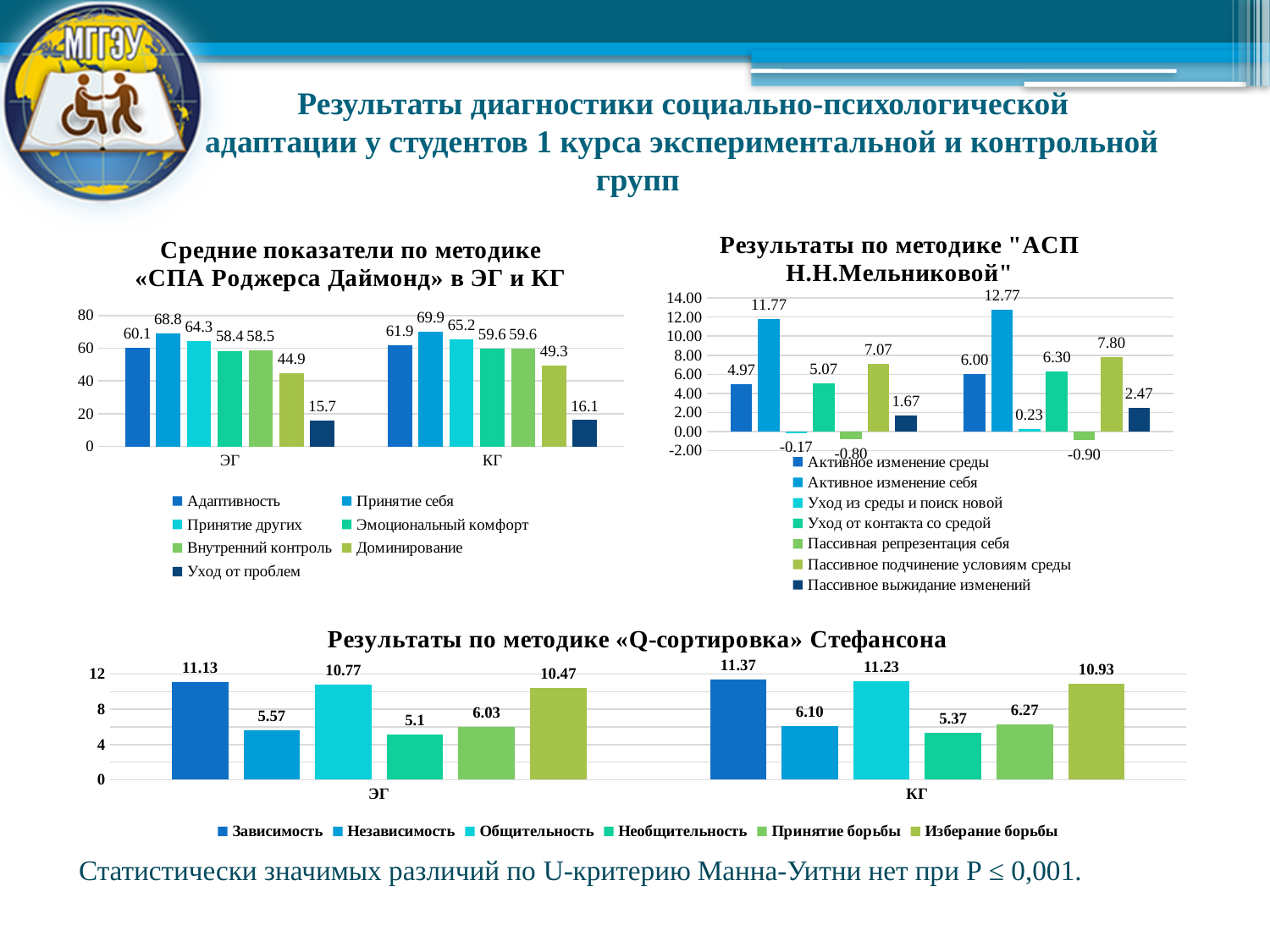
In the chart «Результаты по методике "АСП Н.Н.Мельниковой"», what is the highest value shown in the right-hand group of bars? 12.77 What type of chart is «Результаты по методике "АСП Н.Н.Мельниковой"»? Bar chart In the chart «Результаты по методике «Q-сортировка» Стефансона», which is larger: Зависимость for ЭГ or Избегание борьбы for ЭГ? Зависимость for ЭГ In the chart «Средние показатели по методике «СПА Роджерса Даймонд» в ЭГ и КГ», what is the difference between Доминирование for КГ and for ЭГ? 4.4 How many series does the legend of the chart «Результаты по методике «Q-сортировка» Стефансона» list? 6 In the chart «Результаты по методике "АСП Н.Н.Мельниковой"», what is the value of the Пассивная репрезентация себя bar in the left-hand group? -0.80 In the chart «Результаты по методике "АСП Н.Н.Мельниковой"», what is the difference between the Активное изменение себя values of the right-hand group and the left-hand group? 1.00 In the chart «Средние показатели по методике «СПА Роджерса Даймонд» в ЭГ и КГ», what is the value of Принятие себя for ЭГ? 68.8 In the chart «Средние показатели по методике «СПА Роджерса Даймонд» в ЭГ и КГ», which series has the lowest value for КГ? Уход от проблем In the chart «Результаты по методике «Q-сортировка» Стефансона», what is the value of Общительность for КГ? 11.23 How many series does the legend of the chart «Средние показатели по методике «СПА Роджерса Даймонд» в ЭГ и КГ» list? 7 In the chart «Результаты по методике «Q-сортировка» Стефансона», which series has the lowest value for ЭГ? Необщительность